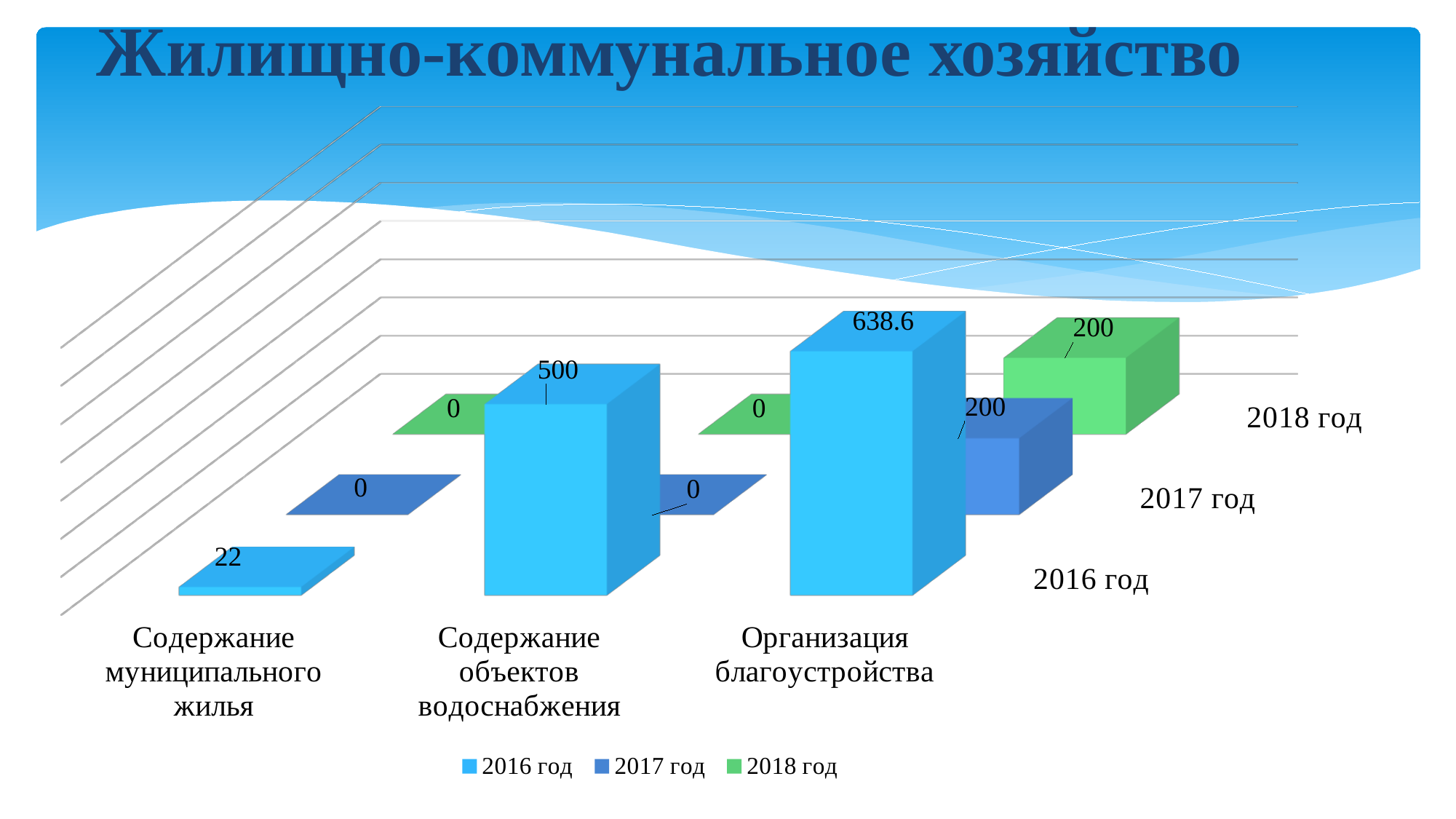
Which category has the highest value in the 2016 год series? Организация благоустройства Which is larger: the 2016 год value for Содержание объектов водоснабжения or the 2018 год value for Организация благоустройства? 2016 год value for Содержание объектов водоснабжения How many series does the legend list? 3 What is the value for Организация благоустройства in the 2018 год series? 200 What is the value for Организация благоустройства in the 2016 год series? 638.6 How many categories are shown on the chart? 3 What type of chart is shown on the slide? Bar chart Which category has the lowest value in the 2016 год series? Содержание муниципального жилья What is the value for Содержание муниципального жилья in the 2016 год series? 22 What is the value for Содержание объектов водоснабжения in the 2017 год series? 0 What is the difference between the 2016 год values for Организация благоустройства and Содержание объектов водоснабжения? 138.6 What is the value for Содержание объектов водоснабжения in the 2016 год series? 500